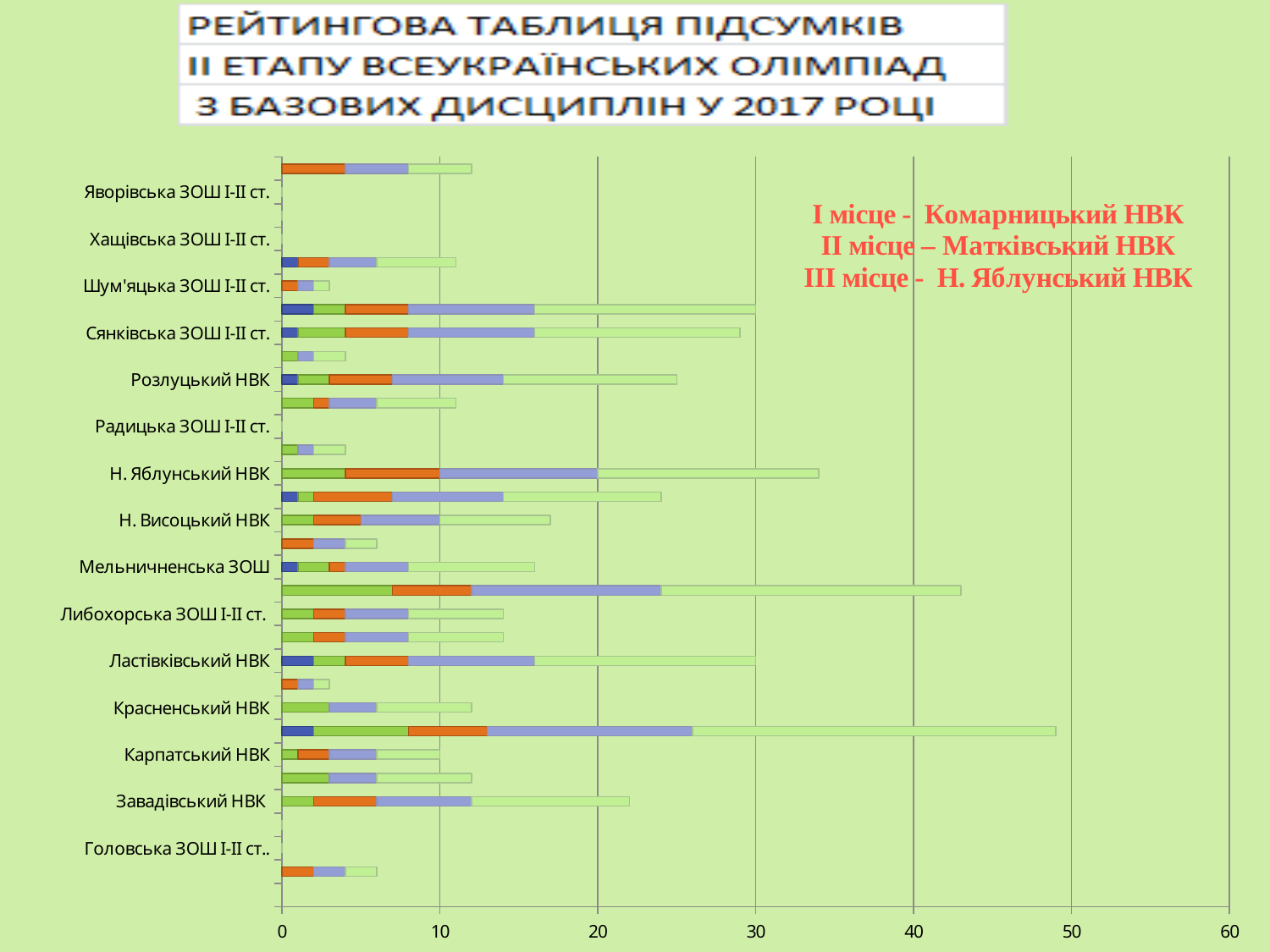
Is the total bar length for Карпатський НВК greater or less than 20? less What is the highest value shown on the horizontal axis? 60 According to the text on the slide, which school took I місце (first place)? Комарницький НВК Which has the longer total bar, Н. Яблунський НВК or Розлуцький НВК? Н. Яблунський НВК Is the total bar length for Н. Яблунський НВК greater or less than 30? greater Is the total bar length for Розлуцький НВК greater or less than 20? greater What type of chart is shown on the slide? Bar chart Which has the longer total bar, Сянківська ЗОШ І-ІІ ст. or Карпатський НВК? Сянківська ЗОШ І-ІІ ст.